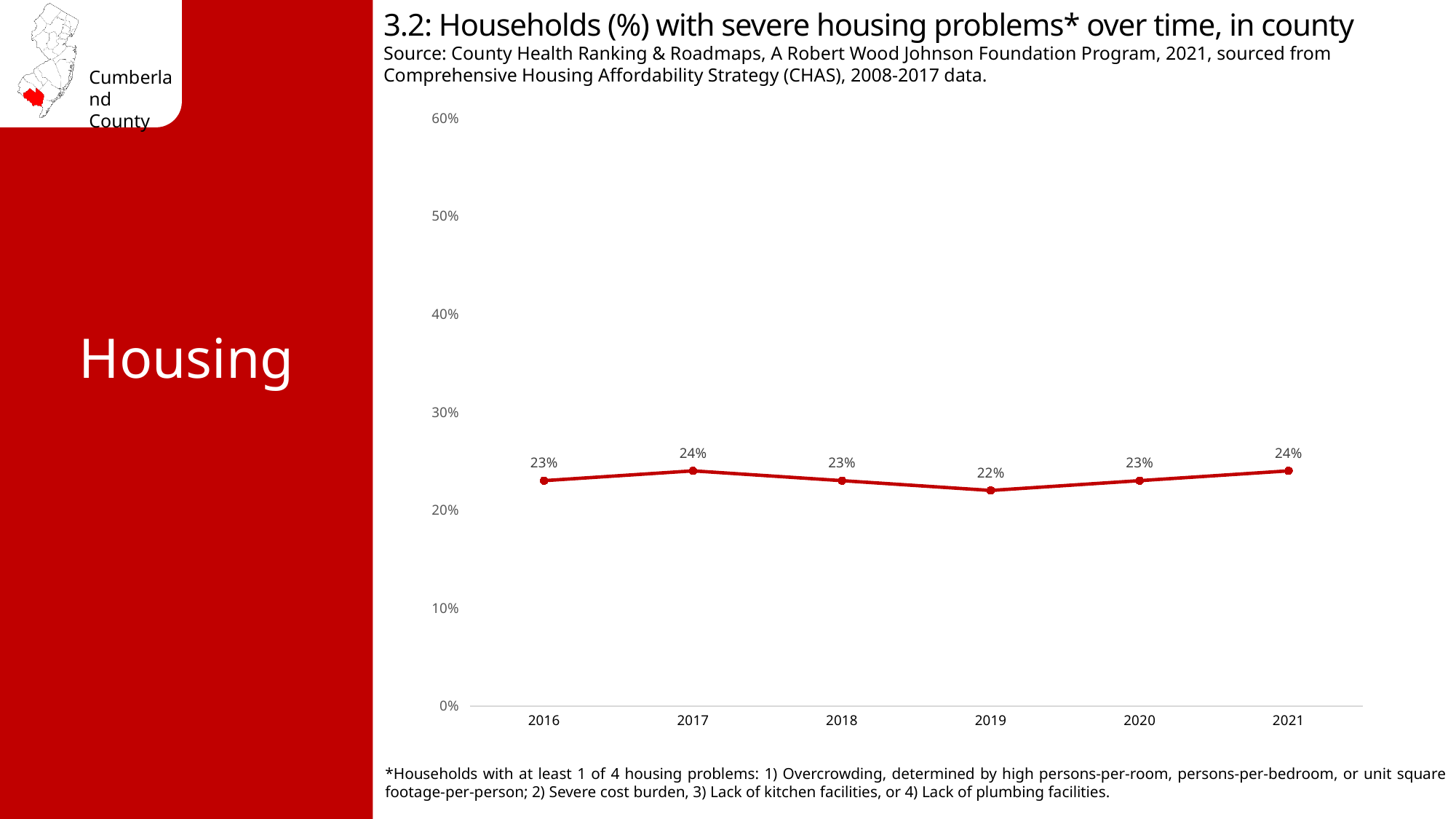
What is the value for 2016? 23% What is the difference between the values for 2017 and 2019? 2 percentage points What is the value for 2021? 24% What is the highest value shown on the y axis? 60% Do the values rise or fall from 2019 to 2021? rise What is the title of the chart? 3.2: Households (%) with severe housing problems* over time, in county Which year has the lowest value? 2019 What kind of chart is shown? line chart Which is larger, the value for 2017 or the value for 2019? 2017 How many years are plotted on the chart? 6 Is the value for 2018 greater or less than 30%? less What is the value for 2019? 22%